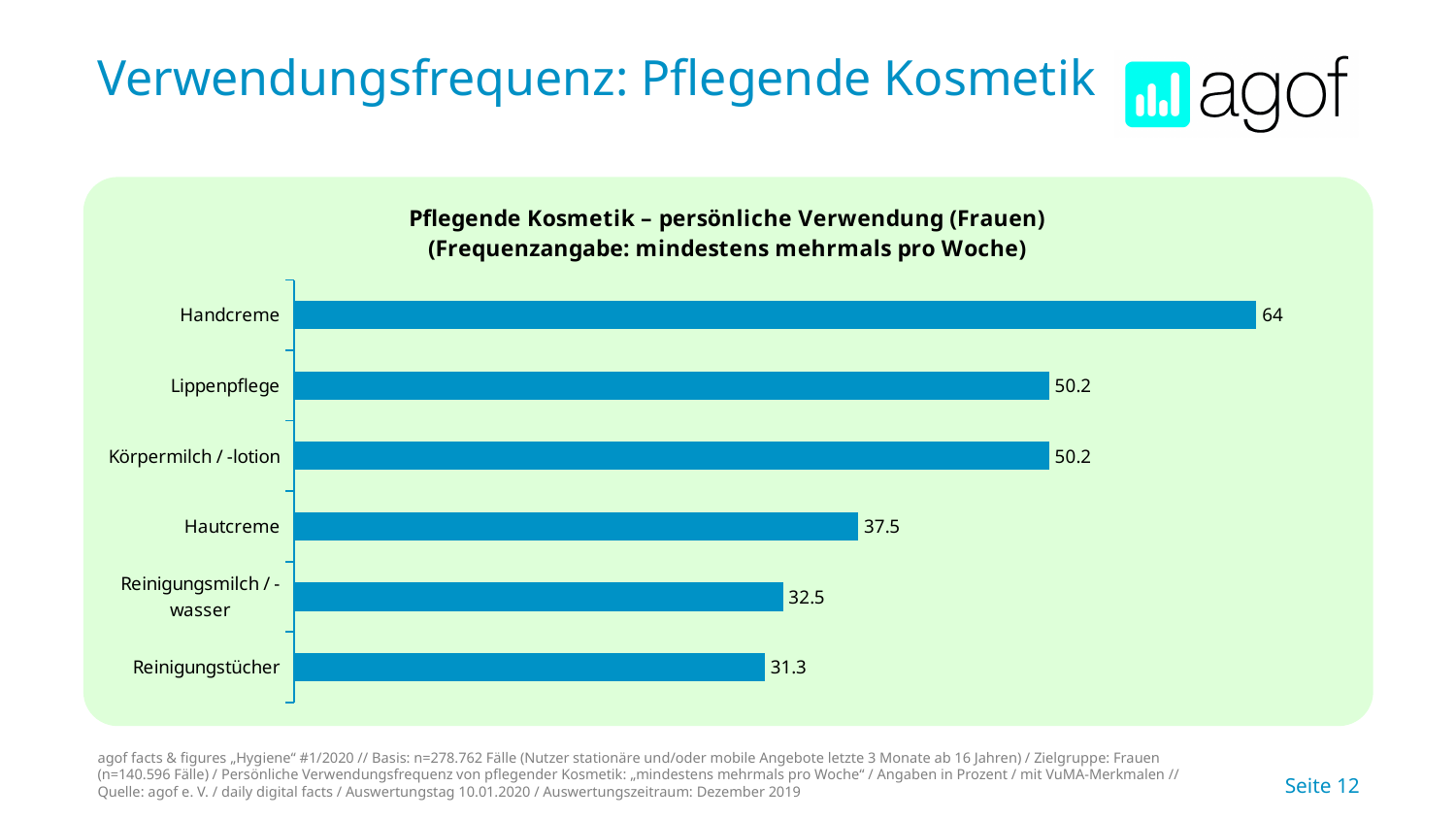
What is the title of the chart? Pflegende Kosmetik – persönliche Verwendung (Frauen) (Frequenzangabe: mindestens mehrmals pro Woche) Which is larger, the value for Hautcreme or the value for Reinigungsmilch / -wasser? Hautcreme What is the value for Reinigungstücher? 31.3 What is the difference between the values for Hautcreme and Reinigungstücher? 6.2 What is the value for Handcreme? 64 What is the difference between the values for Handcreme and Lippenpflege? 13.8 How many categories are shown in the chart? 6 What is the value for Hautcreme? 37.5 Which category has the lowest value? Reinigungstücher What is the value for Reinigungsmilch / -wasser? 32.5 Which category has the highest value? Handcreme What kind of chart is shown on the slide? Bar chart